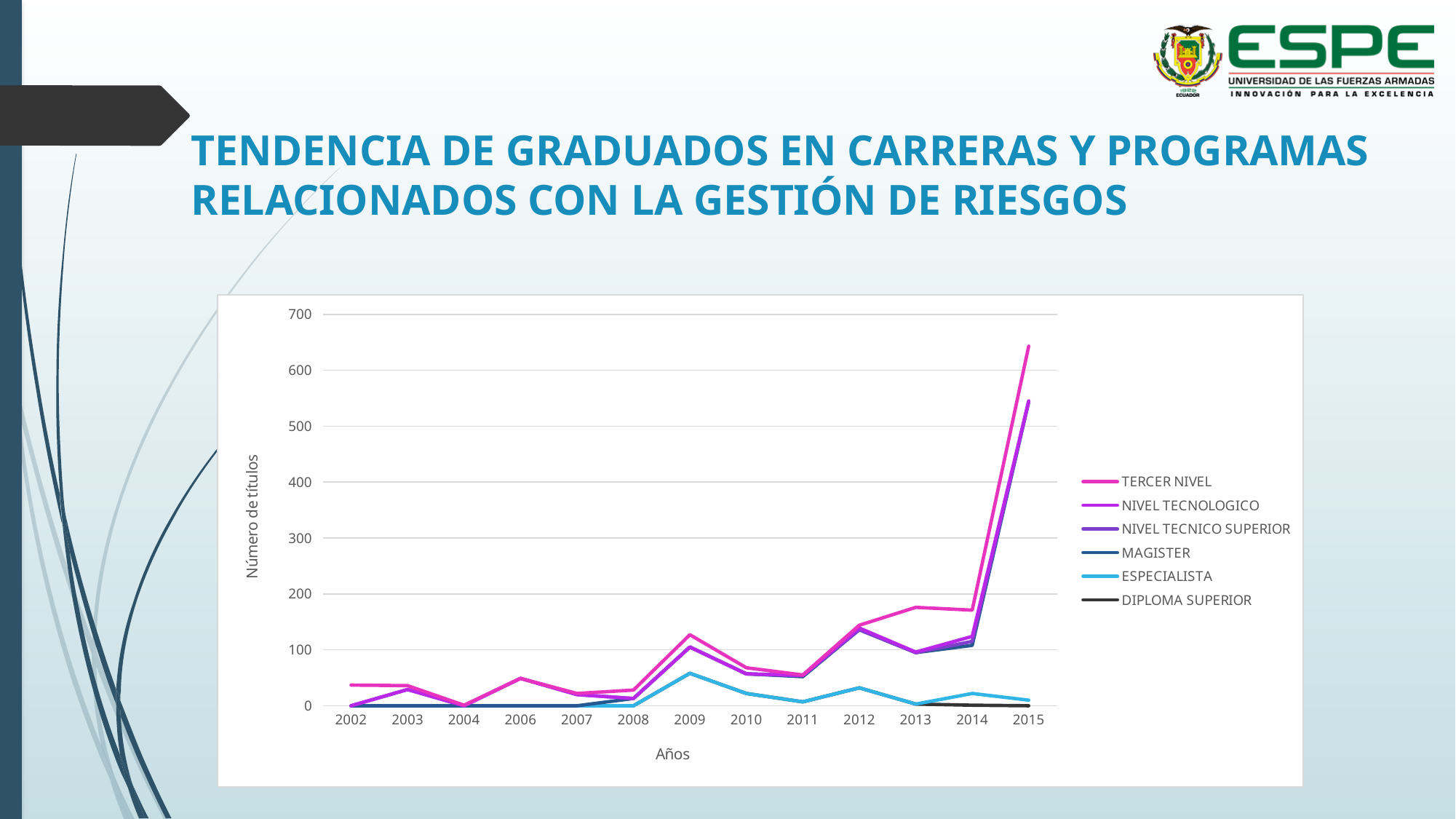
Is the value for ESPECIALISTA in 2009 greater or less than 100? less What is the label of the y axis? Número de títulos In 2015, which is larger: TERCER NIVEL or ESPECIALISTA? TERCER NIVEL How many series does the legend list? 6 Is the value for TERCER NIVEL in 2013 greater or less than 200? less What is the label of the x axis? Años Is the value for NIVEL TECNOLOGICO in 2015 greater or less than 500? greater What kind of chart is shown on the slide? line chart How many years are shown on the x axis? 13 Which series reaches the highest value in 2015? TERCER NIVEL Does the TERCER NIVEL line rise or fall from 2013 to 2015? rise